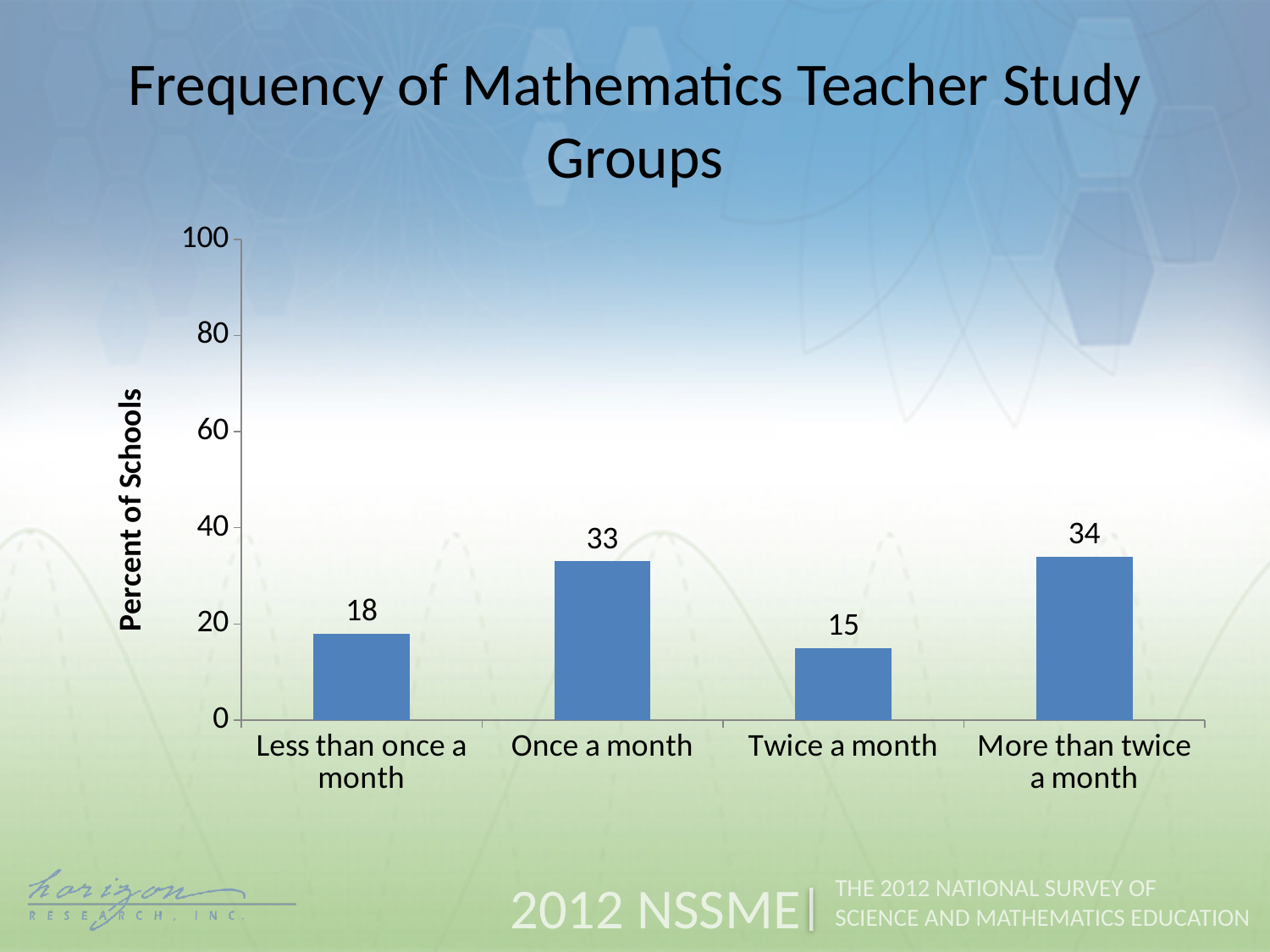
What is the difference between the values for 'Once a month' and 'Less than once a month'? 15 What percent of schools have mathematics teacher study groups once a month? 33 What is the difference between the values for 'More than twice a month' and 'Twice a month'? 19 Is the value for 'Once a month' greater or less than 40? less How many categories are shown on the x axis? 4 What is the label of the vertical axis? Percent of Schools What kind of chart is shown on the slide? bar chart Which is larger: the value for 'Less than once a month' or 'Twice a month'? Less than once a month What is the value for 'Twice a month'? 15 Which category has the lowest percent of schools? Twice a month Which category has the highest percent of schools? More than twice a month What is the value for 'Less than once a month'? 18